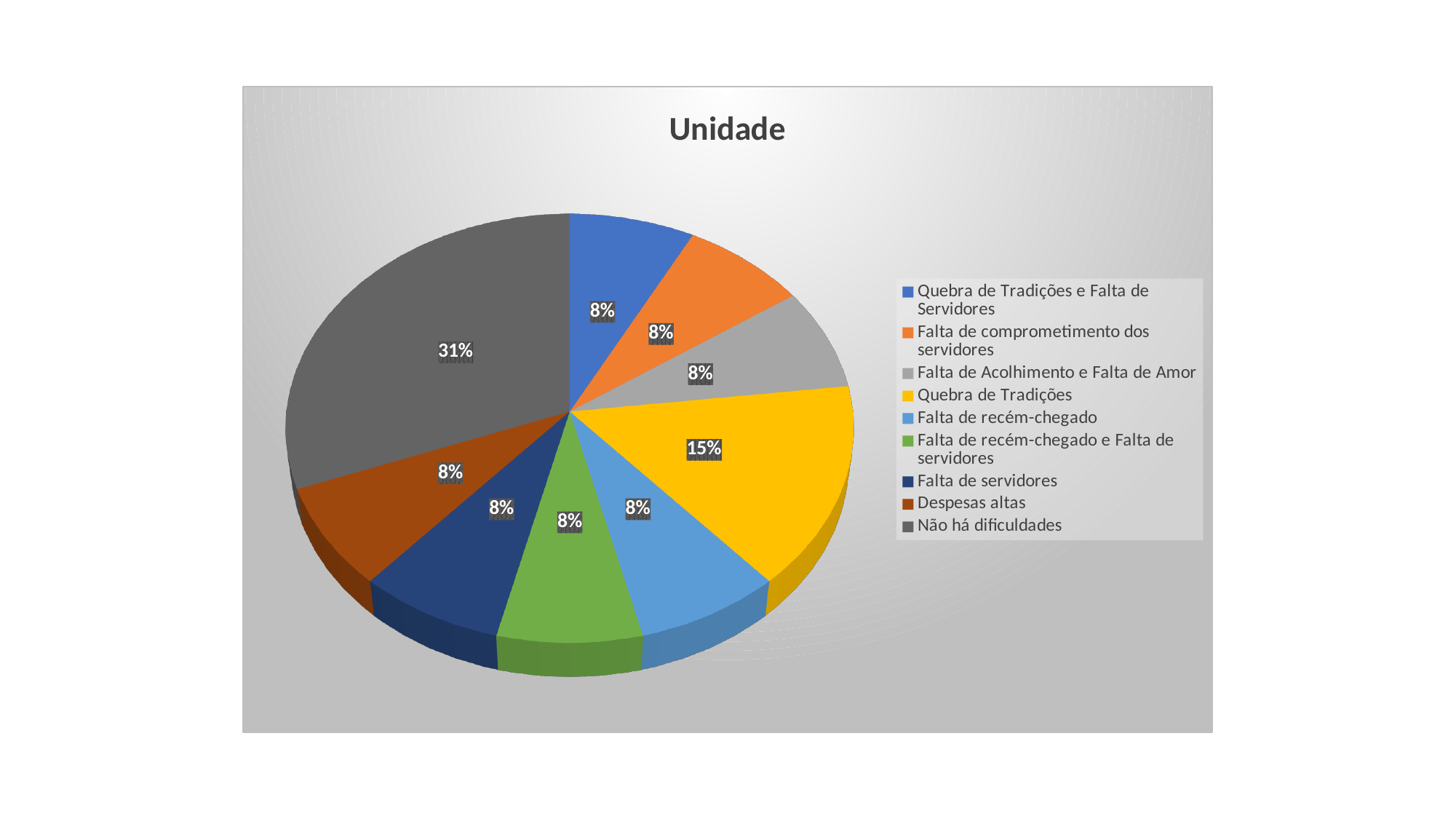
What kind of chart is shown on the slide? pie chart What is the difference between the shares of "Não há dificuldades" and "Quebra de Tradições"? 16% What colour is the slice for "Quebra de Tradições"? yellow What is the difference between the shares of "Quebra de Tradições" and "Falta de Acolhimento e Falta de Amor"? 7% What is the title of the chart? Unidade What is the value shown for "Falta de servidores"? 8% What is the value shown for "Despesas altas"? 8% Which category has the largest share of the pie? Não há dificuldades How many slices does the pie chart have? 9 Which is larger, the share for "Quebra de Tradições" or the share for "Falta de recém-chegado"? Quebra de Tradições What share of the pie does "Não há dificuldades" represent? 31% What share of the pie does "Quebra de Tradições" represent? 15%